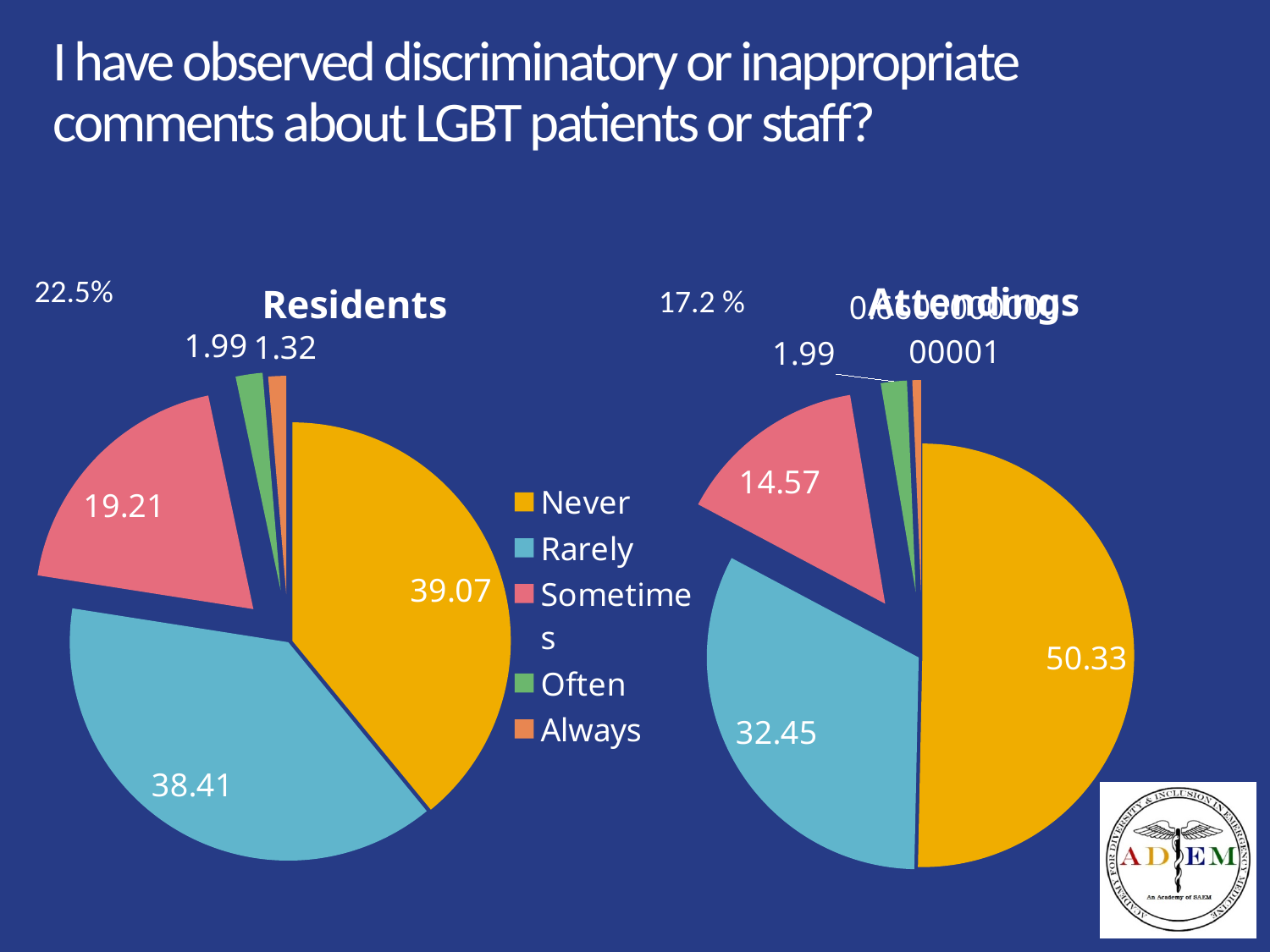
In the Attendings pie chart, what is the value for Rarely? 32.45 Which is larger: the Sometimes value for Residents or the Sometimes value for Attendings? Residents In the Residents pie chart, what is the value for Rarely? 38.41 In the Attendings pie chart, what is the value for Never? 50.33 In the Residents pie chart, which category has the smallest slice? Always In the Attendings pie chart, which category has the largest slice? Never In the Attendings pie chart, what is the value for Sometimes? 14.57 In the Residents pie chart, what is the value for Never? 39.07 In the Residents pie chart, what is the difference between the Never and Rarely values? 0.66 In the Residents pie chart, what is the value for Sometimes? 19.21 How many categories does the legend list for the pie charts? 5 In the Residents pie chart, what is the value for Always? 1.32